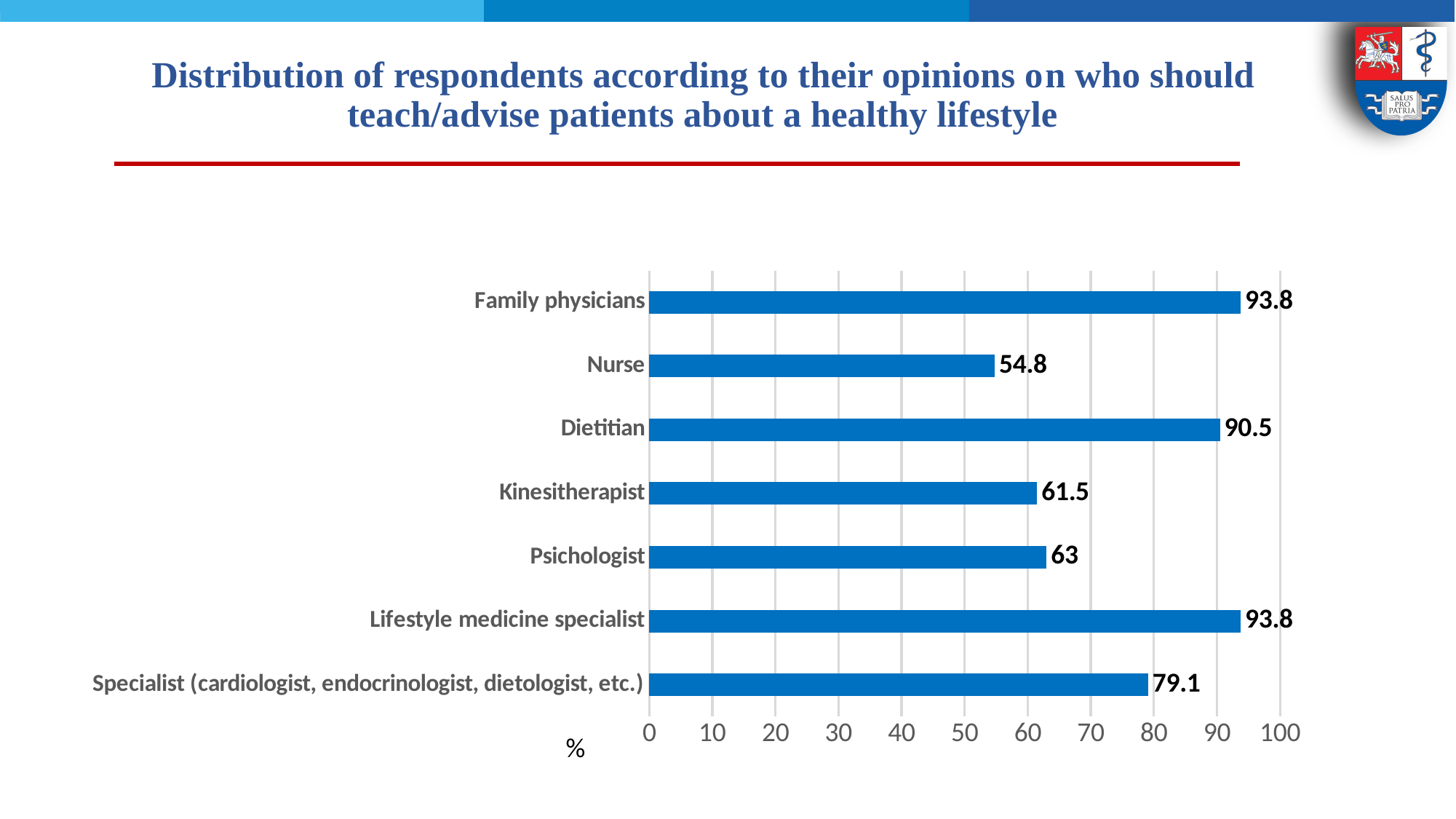
Which is larger, the value for Dietitian or the value for Psichologist? Dietitian What unit is indicated on the horizontal axis of the chart? % What is the value for Specialist (cardiologist, endocrinologist, dietologist, etc.)? 79.1 What is the difference between the values for Family physicians and Nurse? 39 What kind of chart is shown on the slide? Bar chart What is the value for Dietitian? 90.5 What is the difference between the values for Dietitian and Specialist (cardiologist, endocrinologist, dietologist, etc.)? 11.4 Which category has the lowest value? Nurse What is the value for Kinesitherapist? 61.5 What is the value for Nurse? 54.8 What is the value for Lifestyle medicine specialist? 93.8 How many categories are shown in the chart? 7